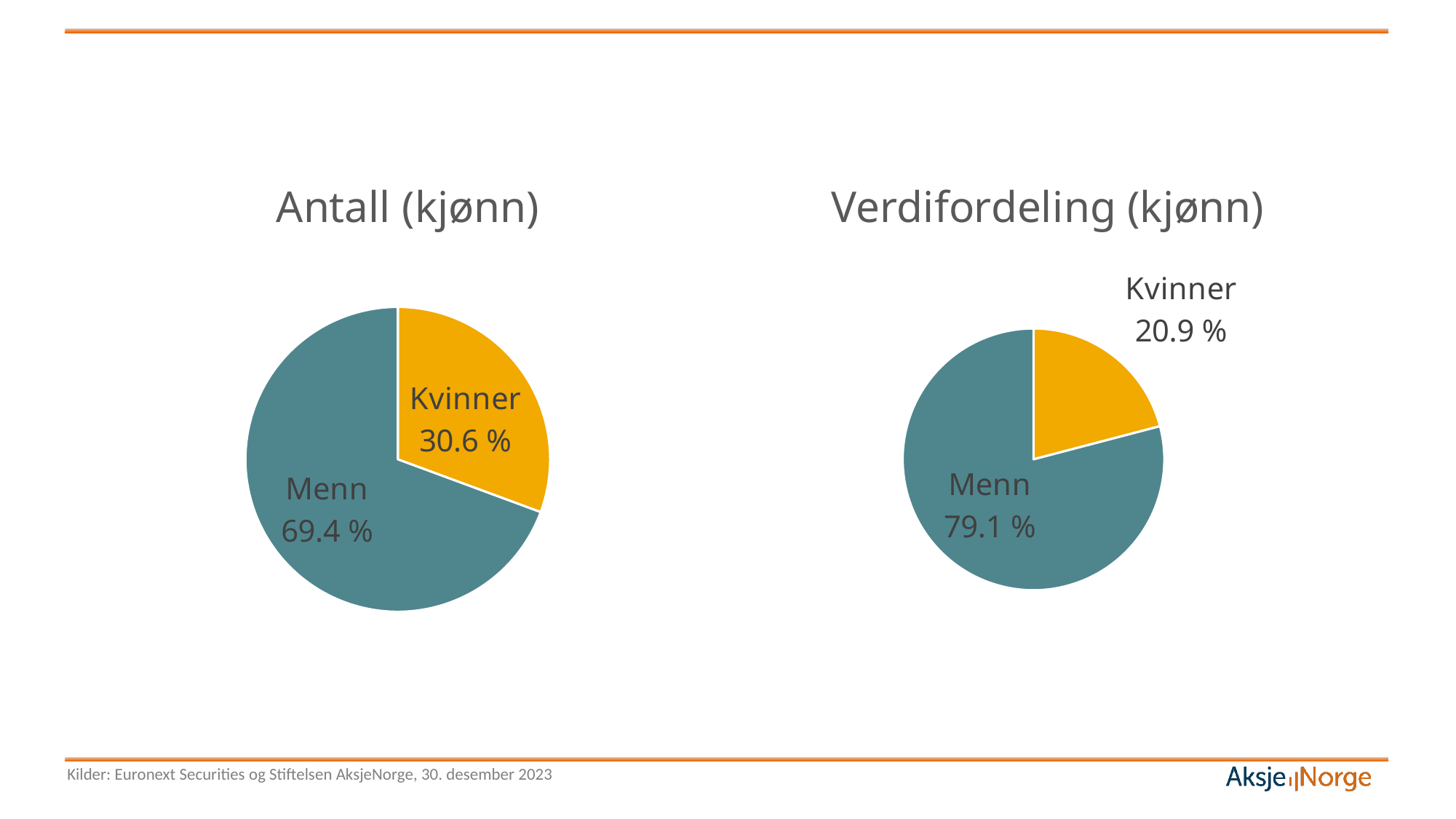
In the 'Antall (kjønn)' chart, which slice is the largest? Menn In the 'Verdifordeling (kjønn)' chart, what share is labelled for Kvinner? 20.9 % Is the Kvinner share larger in the 'Antall (kjønn)' chart or in the 'Verdifordeling (kjønn)' chart? Antall (kjønn) What kind of chart is 'Verdifordeling (kjønn)'? Pie chart In the 'Verdifordeling (kjønn)' chart, which slice is the smallest? Kvinner In the 'Antall (kjønn)' chart, what share is labelled for Kvinner? 30.6 % In the 'Antall (kjønn)' chart, what share is labelled for Menn? 69.4 % In the 'Antall (kjønn)' chart, what is the difference in percentage points between Menn and Kvinner? 38.8 In the 'Verdifordeling (kjønn)' chart, what is the difference in percentage points between Menn and Kvinner? 58.2 In the 'Verdifordeling (kjønn)' chart, what share is labelled for Menn? 79.1 % What colour is the Kvinner slice in the 'Antall (kjønn)' chart? Yellow How many slices does the 'Antall (kjønn)' chart have? 2